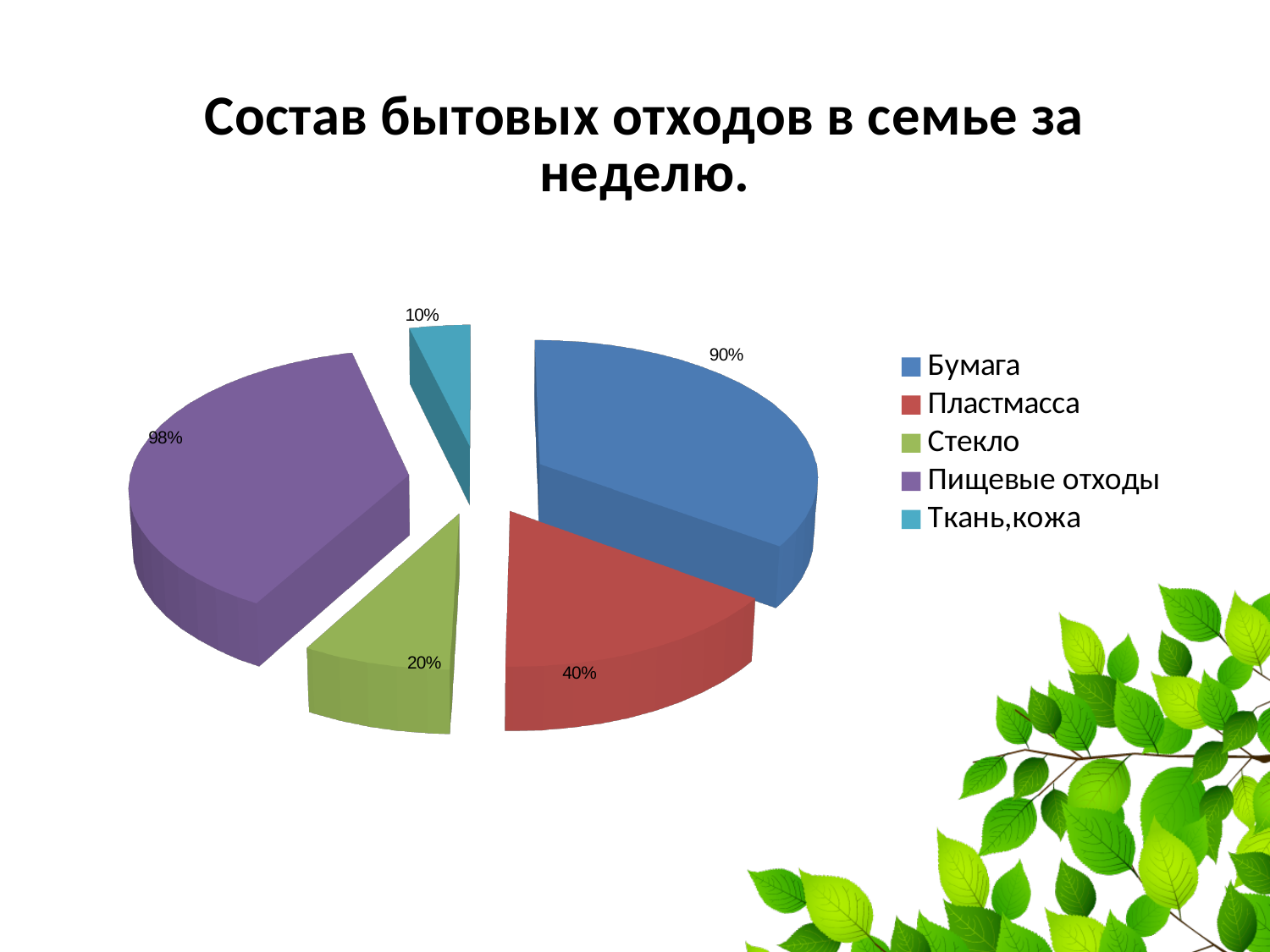
What is the value labelled for Стекло? 20% Which category has the smallest labelled value? Ткань,кожа How many categories does the legend list? 5 What is the value labelled for Пластмасса? 40% What is the title of the chart on the slide? Состав бытовых отходов в семье за неделю. What is the value labelled for Бумага? 90% What is the difference between the labelled values for Пищевые отходы and Бумага? 8% Which category has the largest labelled value? Пищевые отходы Which is larger, the value for Пластмасса or the value for Стекло? Пластмасса What is the value labelled for Пищевые отходы? 98% What is the value labelled for Ткань,кожа? 10% What type of chart is shown on the slide? pie chart